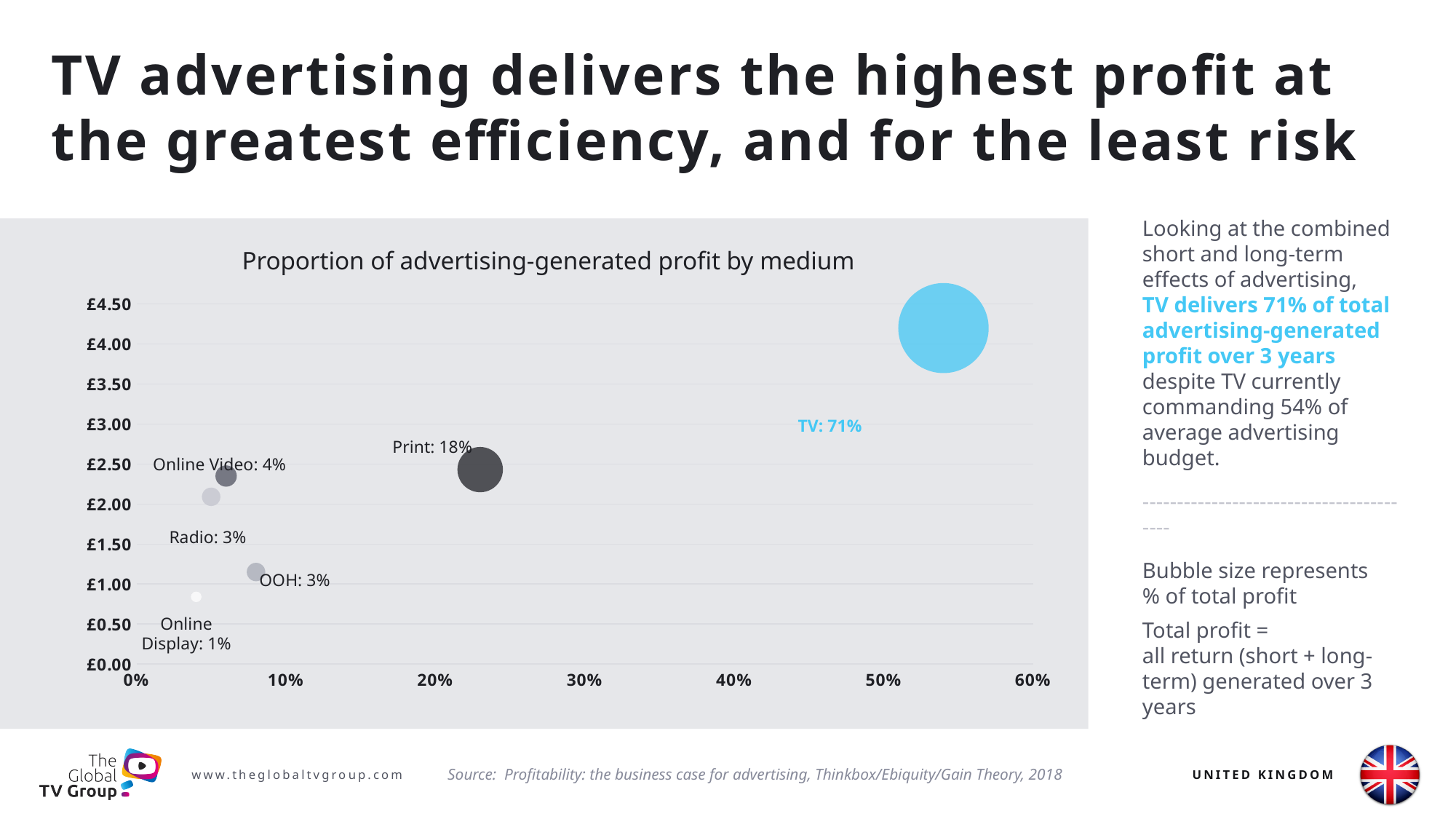
What percentage of total profit is labelled for TV? 71% What percentage of total profit is labelled for Online Display? 1% How many percentage points higher is TV's share of total profit than Print's? 53 Which has a larger share of total profit, Print or Online Video? Print How many media (bubbles) are plotted on the chart? 6 Which medium has the largest share of total profit? TV What percentage of total profit is labelled for Online Video? 4% What percentage of total profit is labelled for Print? 18% What is the chart's title? Proportion of advertising-generated profit by medium Is the TV bubble's position on the horizontal axis greater or less than 50%? greater What kind of chart is shown on the slide? Bubble chart Which medium has the smallest share of total profit? Online Display